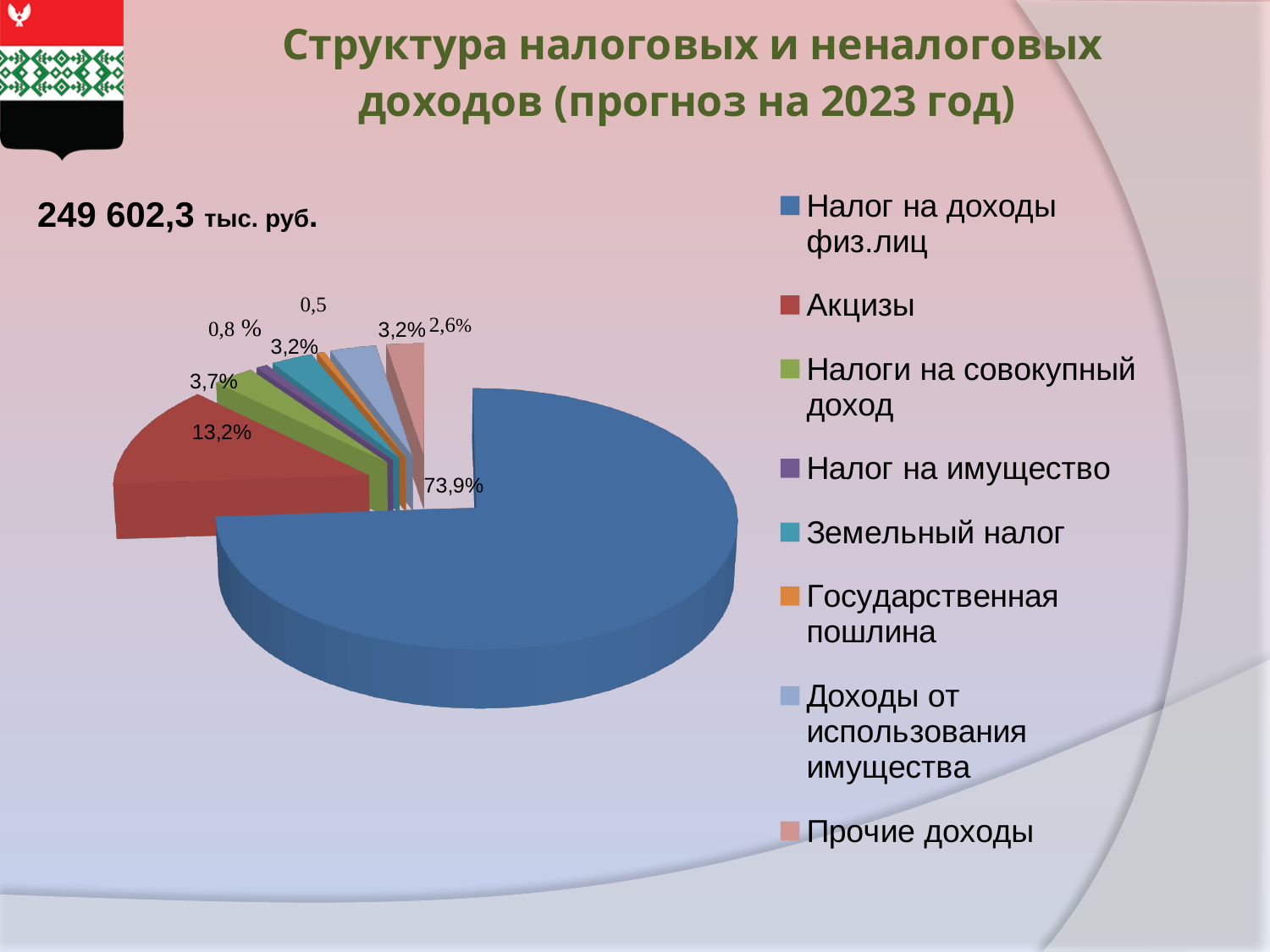
What kind of chart is shown on the slide? pie chart What share of the pie is labelled for Налоги на совокупный доход? 3,7% Which category has the largest share of the pie? Налог на доходы физ.лиц What share of the pie is labelled for Налог на доходы физ.лиц? 73,9% What total amount in thousand rubles is shown next to the pie chart? 249 602,3 тыс. руб. What is the difference in percentage points between the shares of Налог на доходы физ.лиц and Акцизы? 60,7 What share of the pie is labelled for Акцизы? 13,2% Which has the larger share: Акцизы or Налоги на совокупный доход? Акцизы What is the title of the slide's chart? Структура налоговых и неналоговых доходов (прогноз на 2023 год) What share of the pie is labelled for Прочие доходы? 2,6% How many categories does the legend of the pie chart list? 8 Which has the larger share: Налоги на совокупный доход or Прочие доходы? Налоги на совокупный доход